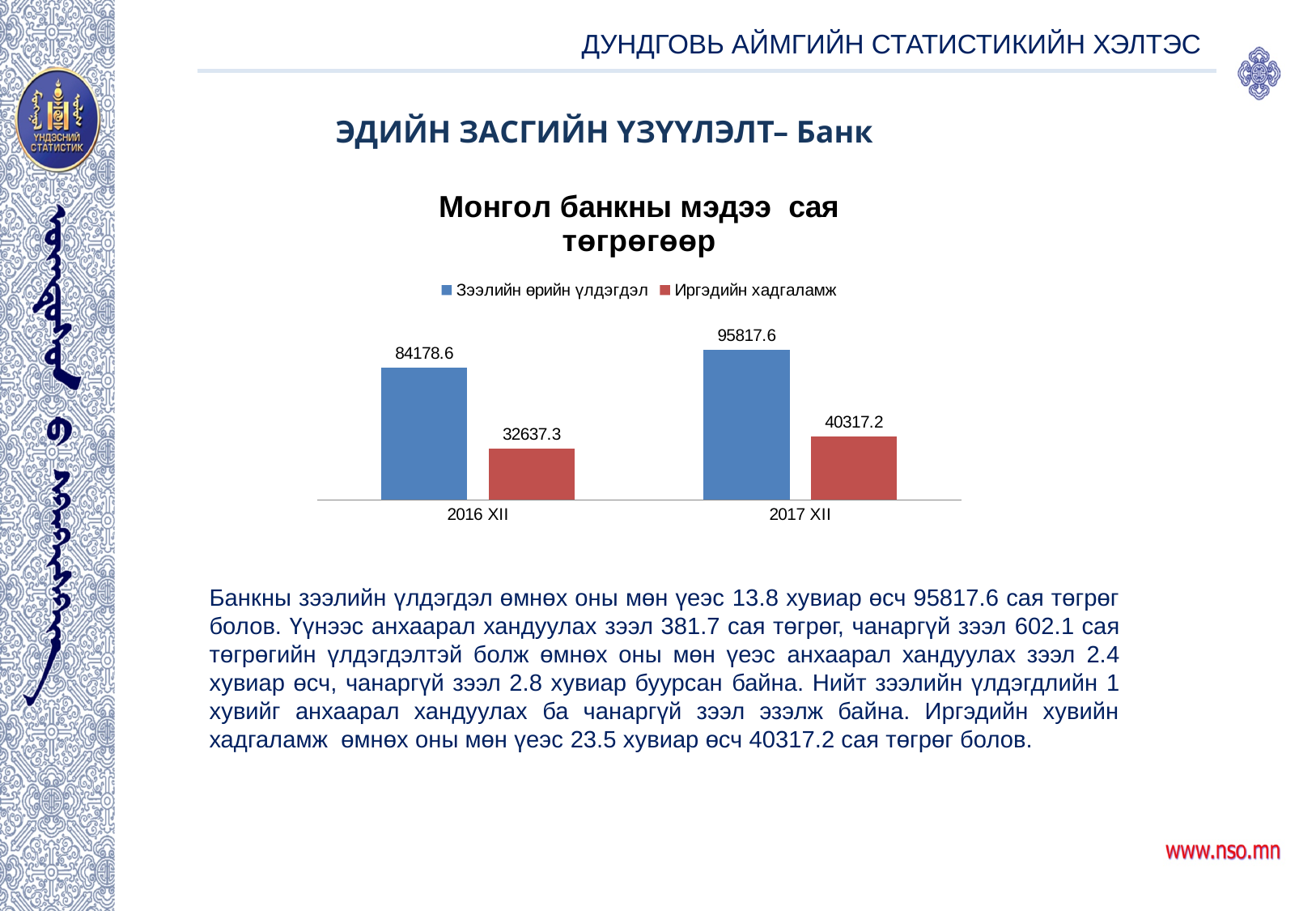
How many categories are shown on the x axis? 2 Which category has the highest value for Зээлийн өрийн үлдэгдэл? 2017 XII What is the value of Иргэдийн хадгаламж for 2017 XII? 40317.2 What is the value of Зээлийн өрийн үлдэгдэл for 2017 XII? 95817.6 By how much did Зээлийн өрийн үлдэгдэл increase from 2016 XII to 2017 XII? 11639.0 Which is larger in 2016 XII, Зээлийн өрийн үлдэгдэл or Иргэдийн хадгаламж? Зээлийн өрийн үлдэгдэл What kind of chart is shown on the slide? Bar chart What is the difference between Зээлийн өрийн үлдэгдэл and Иргэдийн хадгаламж in 2017 XII? 55500.4 What is the value of Иргэдийн хадгаламж for 2016 XII? 32637.3 What is the value of Зээлийн өрийн үлдэгдэл for 2016 XII? 84178.6 How many series does the legend list? 2 Which category has the lowest value for Иргэдийн хадгаламж? 2016 XII